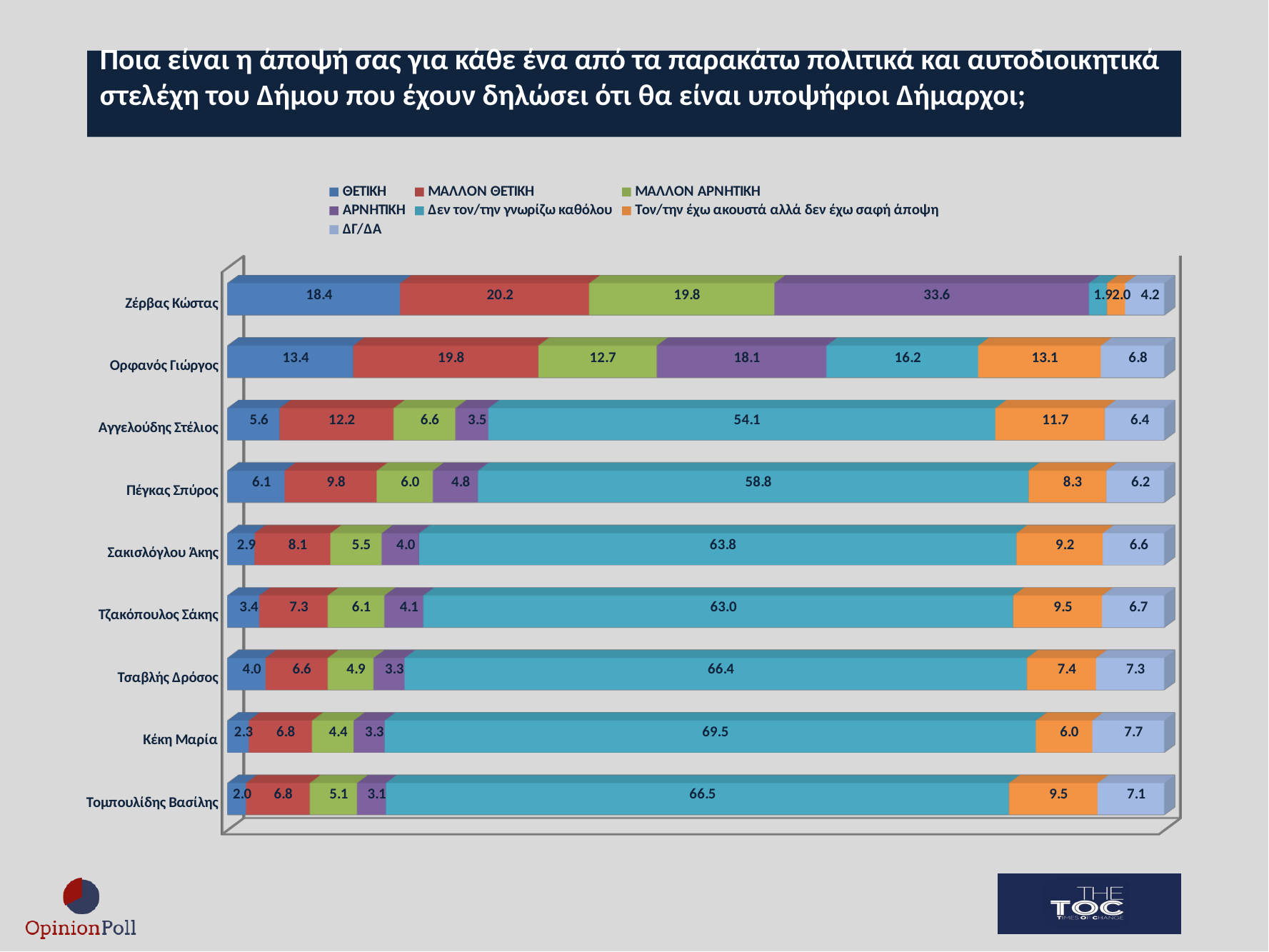
Which is larger: the ΜΑΛΛΟΝ ΘΕΤΙΚΗ value for Αγγελούδης Στέλιος or for Πέγκας Σπύρος? Αγγελούδης Στέλιος What is the ΘΕΤΙΚΗ value for Ζέρβας Κώστας? 18.4 Which candidate has the highest 'Δεν τον/την γνωρίζω καθόλου' value? Κέκη Μαρία Which candidate has the highest ΘΕΤΙΚΗ value? Ζέρβας Κώστας Which candidate has the lowest ΘΕΤΙΚΗ value? Τομπουλίδης Βασίλης What is the difference between the ΑΡΝΗΤΙΚΗ values for Ζέρβας Κώστας and Ορφανός Γιώργος? 15.5 What is the 'Δεν τον/την γνωρίζω καθόλου' value for Πέγκας Σπύρος? 58.8 What is the ΑΡΝΗΤΙΚΗ value for Ορφανός Γιώργος? 18.1 How many candidates are shown in the chart? 9 Which colour represents the ΔΓ/ΔΑ series in the legend? Light blue How many series does the legend list? 7 What kind of chart is shown on the slide? Stacked bar chart